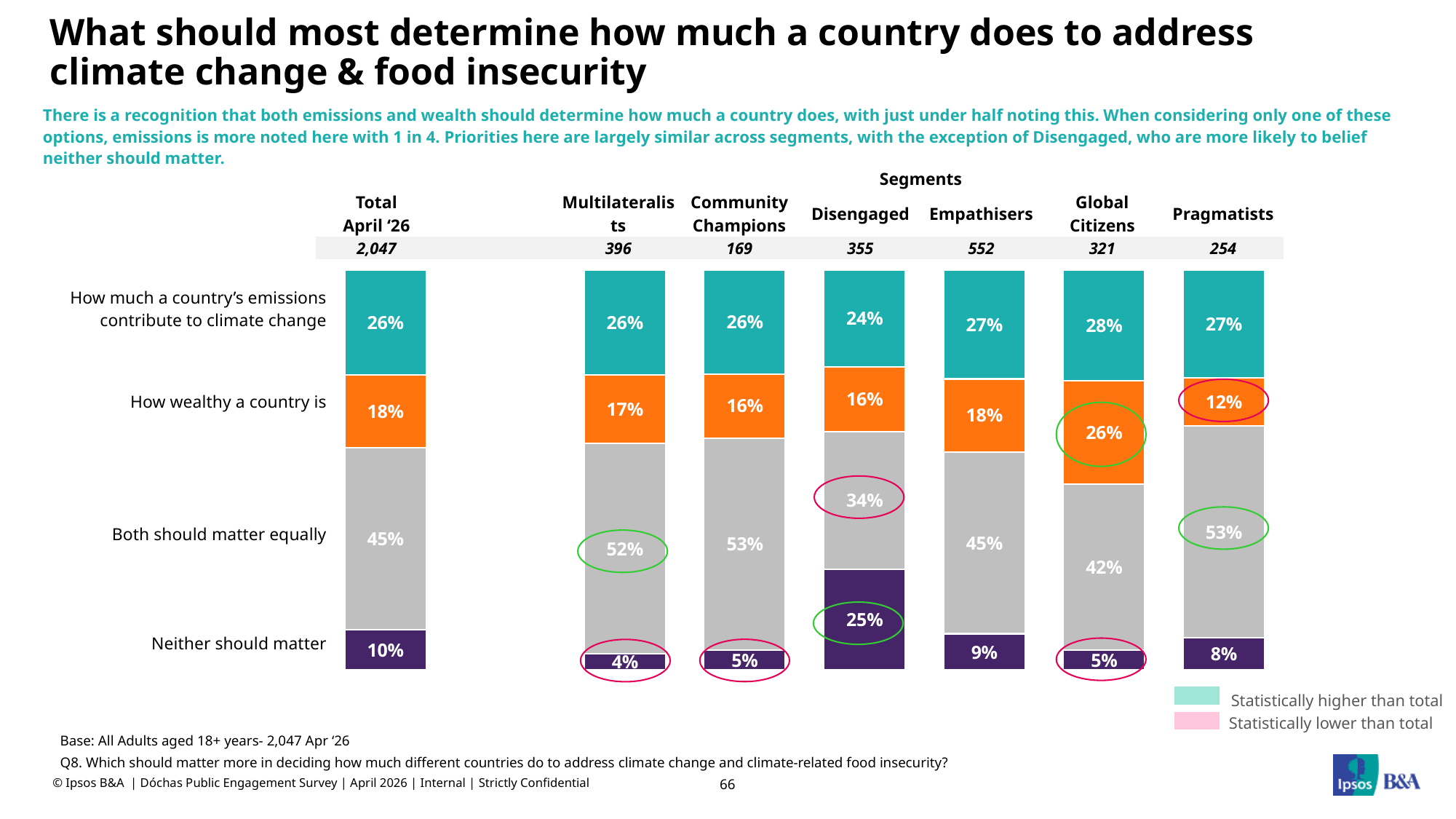
How many response options are stacked within each bar? 4 Which segment has the highest share saying neither should matter? Disengaged Which has a larger share saying neither should matter: Multilateralists or Empathisers? Empathisers What percentage of the Total April '26 sample say both should matter equally? 45% What percentage of Global Citizens say how wealthy a country is should most determine what it does? 26% What percentage of Community Champions say how much a country's emissions contribute to climate change should matter most? 26% What kind of chart is shown on the slide? Stacked bar chart What percentage of the Disengaged segment say neither should matter? 25% What is the total of the four segments in the Pragmatists bar? 100% How many stacked bars are shown in the chart? 7 How many percentage points lower is the 'Both should matter equally' share for Disengaged than for the Total? 11 percentage points Which segment has the lowest share saying how wealthy a country is should matter most? Pragmatists